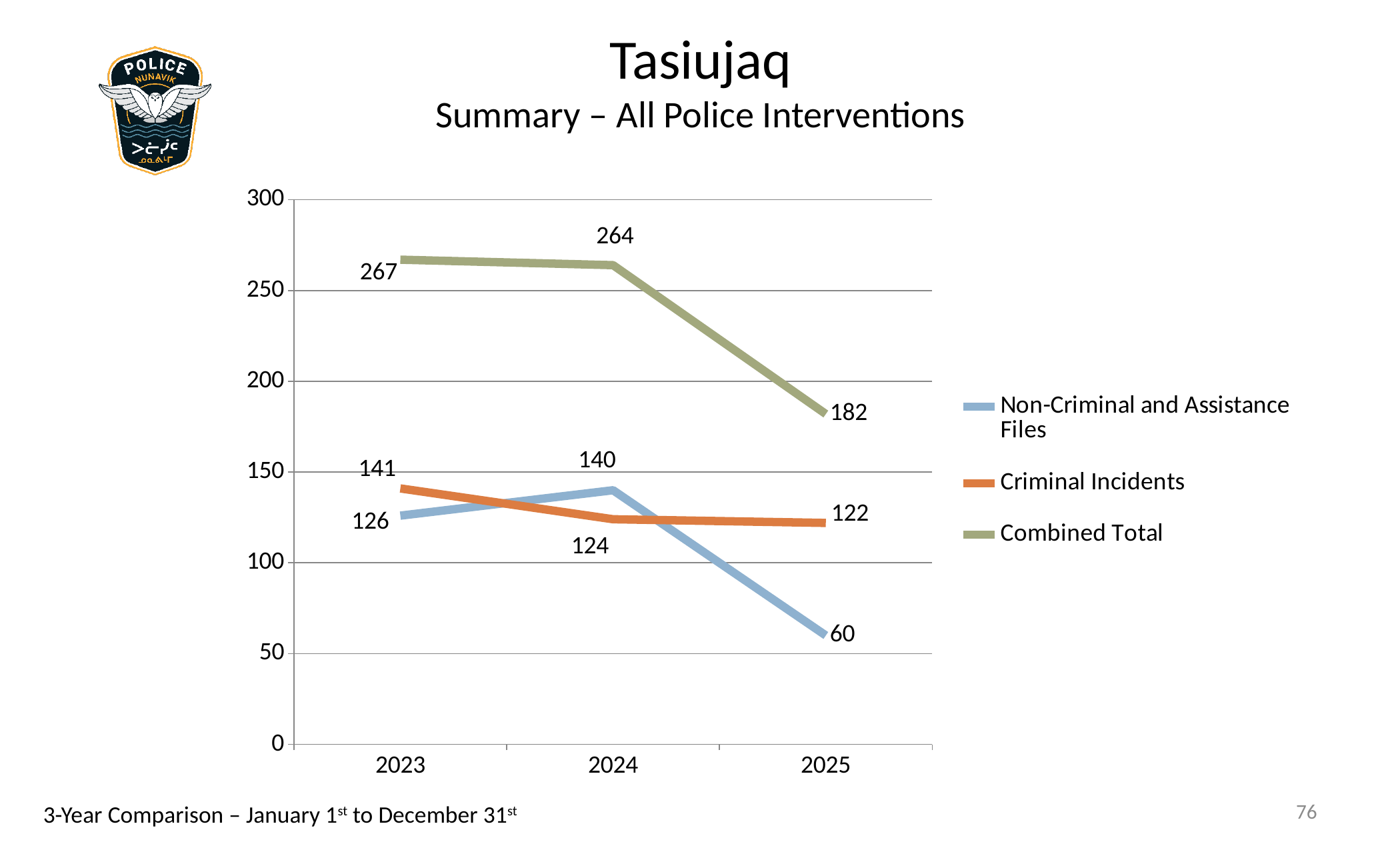
How many years are shown on the x axis? 3 What kind of chart is shown on the slide? line chart Does the Combined Total rise or fall from 2023 to 2025? fall What is the Combined Total value for 2025? 182 How many series does the legend list? 3 What is the difference between the Combined Total in 2024 and in 2025? 82 In which year is the Combined Total highest? 2023 In which year is the value for Non-Criminal and Assistance Files lowest? 2025 What is the value for Criminal Incidents in 2023? 141 Is the value for Non-Criminal and Assistance Files in 2025 greater or less than 100? less Which is larger in 2025: Criminal Incidents or Non-Criminal and Assistance Files? Criminal Incidents What is the value for Non-Criminal and Assistance Files in 2024? 140